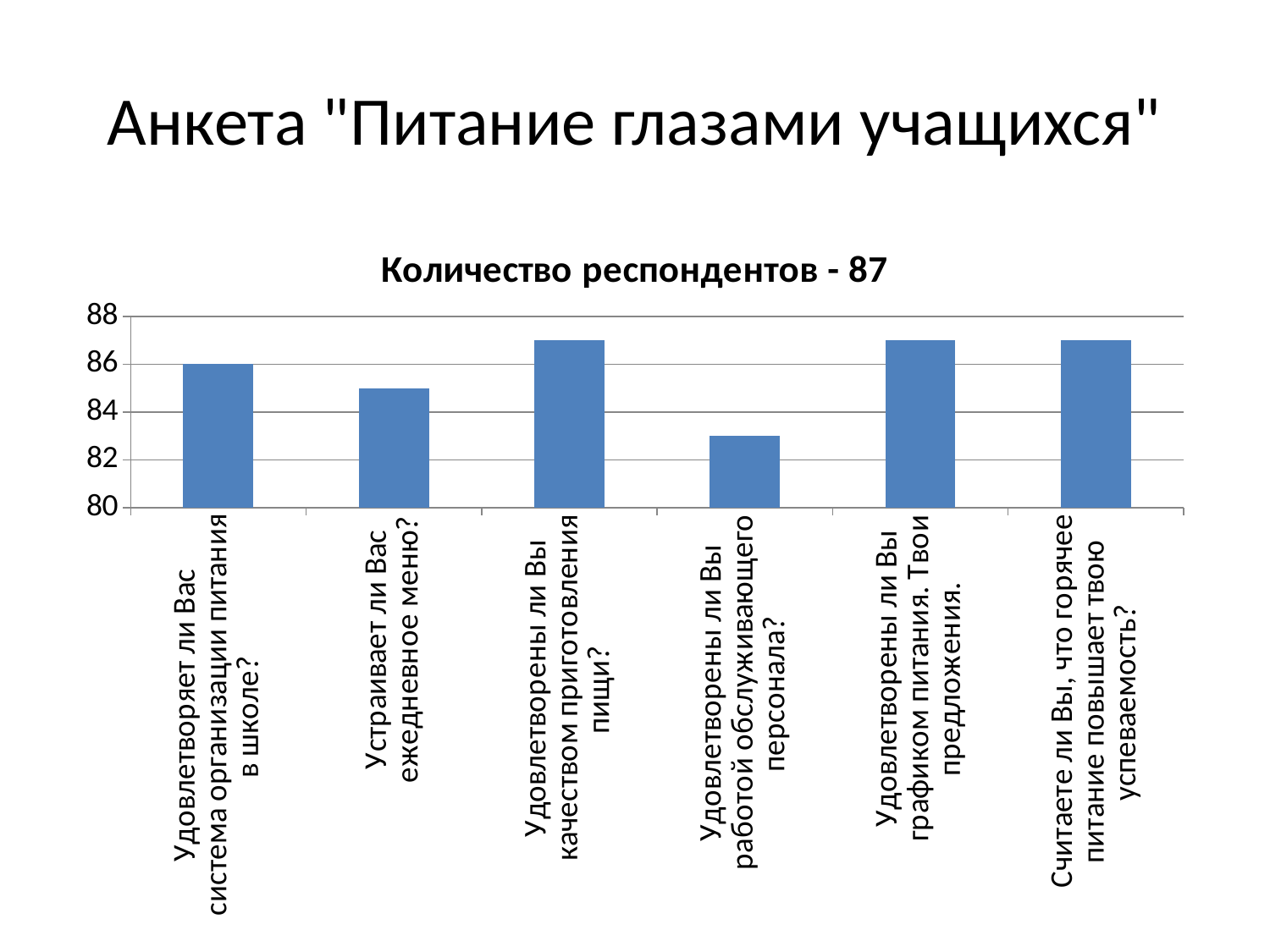
Which is larger: the value for "Удовлетворяет ли Вас система организации питания в школе?" or the value for "Удовлетворены ли Вы работой обслуживающего персонала?"? Удовлетворяет ли Вас система организации питания в школе? What is the title of the chart? Количество респондентов - 87 Is the value for "Удовлетворены ли Вы графиком питания. Твои предложения." greater or less than 86? greater How many categories (questions) are shown on the x axis of the chart? 6 What type of chart is shown on the slide? bar chart Is the value for "Устраивает ли Вас ежедневное меню?" greater or less than 84? greater Which is larger: the value for "Удовлетворены ли Вы качеством приготовления пищи?" or the value for "Удовлетворены ли Вы работой обслуживающего персонала?"? Удовлетворены ли Вы качеством приготовления пищи? Is the value for "Удовлетворены ли Вы работой обслуживающего персонала?" greater or less than 84? less What is the value for "Удовлетворяет ли Вас система организации питания в школе?"? 86 Which category has the lowest value? Удовлетворены ли Вы работой обслуживающего персонала?